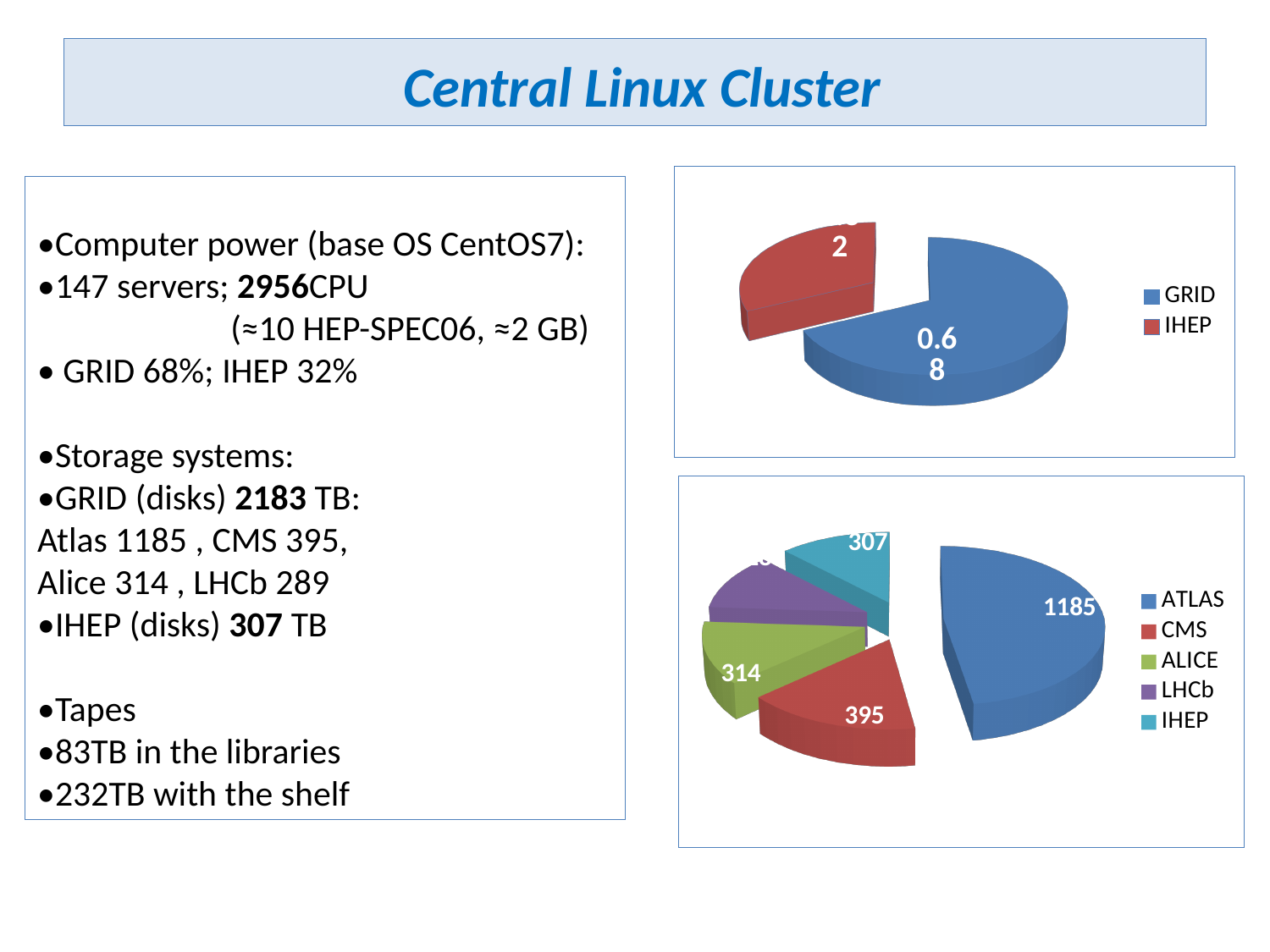
In the bottom pie chart, which category has the largest slice? ATLAS In the top pie chart, which category has the largest slice? GRID What kind of chart is the top chart on the right of the slide? pie chart In the bottom pie chart, how many categories does the legend list? 5 In the top pie chart, which slice is larger, GRID or IHEP? GRID In the bottom pie chart, what is the value for CMS? 395 In the bottom pie chart, what is the difference between the ATLAS value and the CMS value? 790 In the bottom pie chart, what is the value for ATLAS? 1185 What kind of chart is the bottom chart on the right of the slide? pie chart In the bottom pie chart, what is the value for ALICE? 314 In the bottom pie chart, what is the value for IHEP? 307 In the top pie chart, how many entries does the legend list? 2